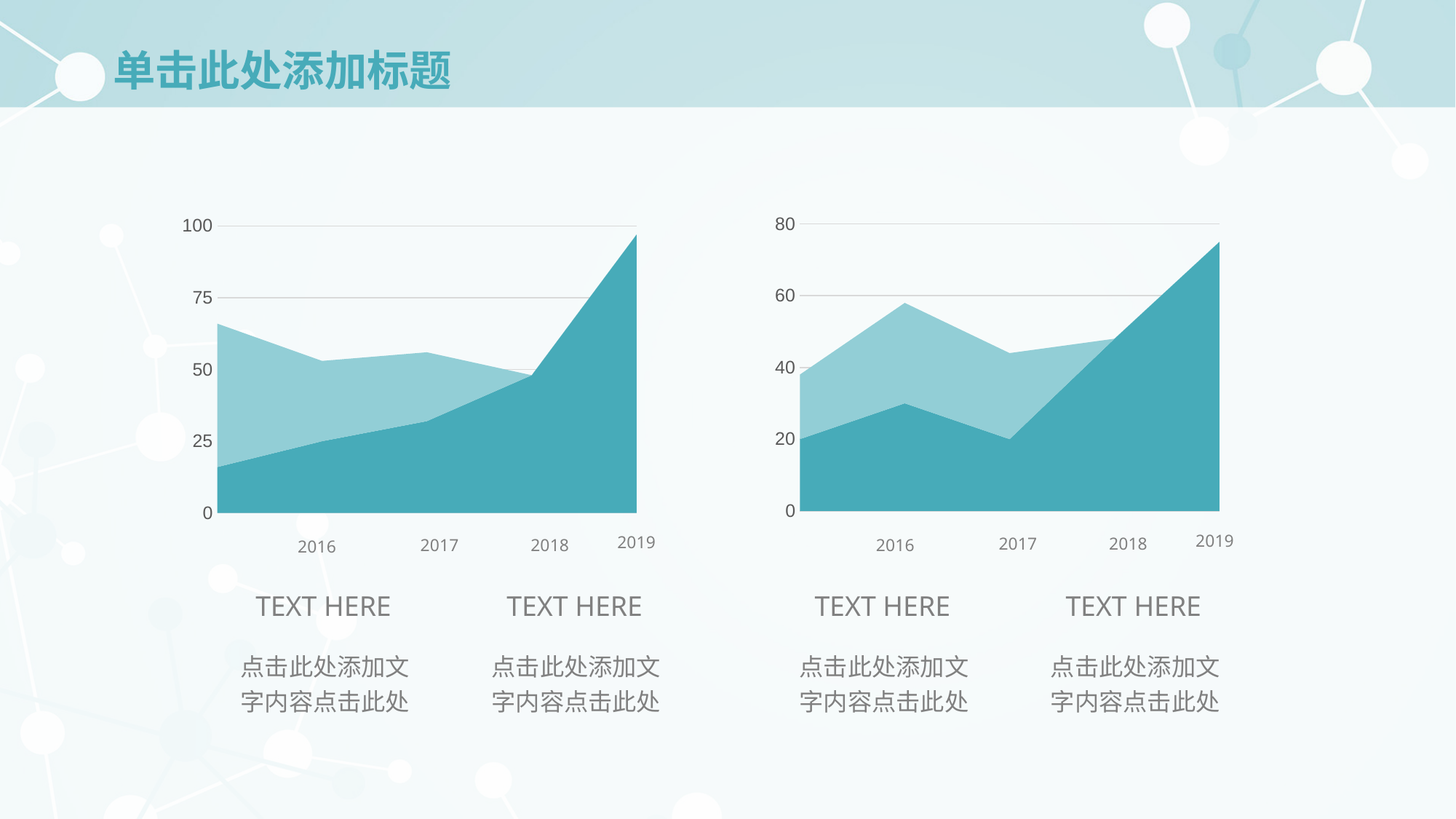
In the right chart, in which labelled year does the darker series reach its lowest value? 2017 In the right chart, is the value of the darker series for 2016 greater or less than 20? greater In the left chart, in which labelled year does the darker series reach its highest value? 2019 What kind of chart is the left chart on the slide? area chart In the right chart, is the value of the darker series for 2019 greater or less than 60? greater In the left chart, is the value of the darker series for 2019 greater or less than 75? greater What is the highest value shown on the y axis of the right chart? 80 How many year labels are shown on the x axis of the right chart? 4 How many shaded series are plotted in the left chart? 2 In the left chart, does the darker series rise or fall from 2016 to 2019? rise In the right chart, is the darker series larger in 2018 or in 2017? 2018